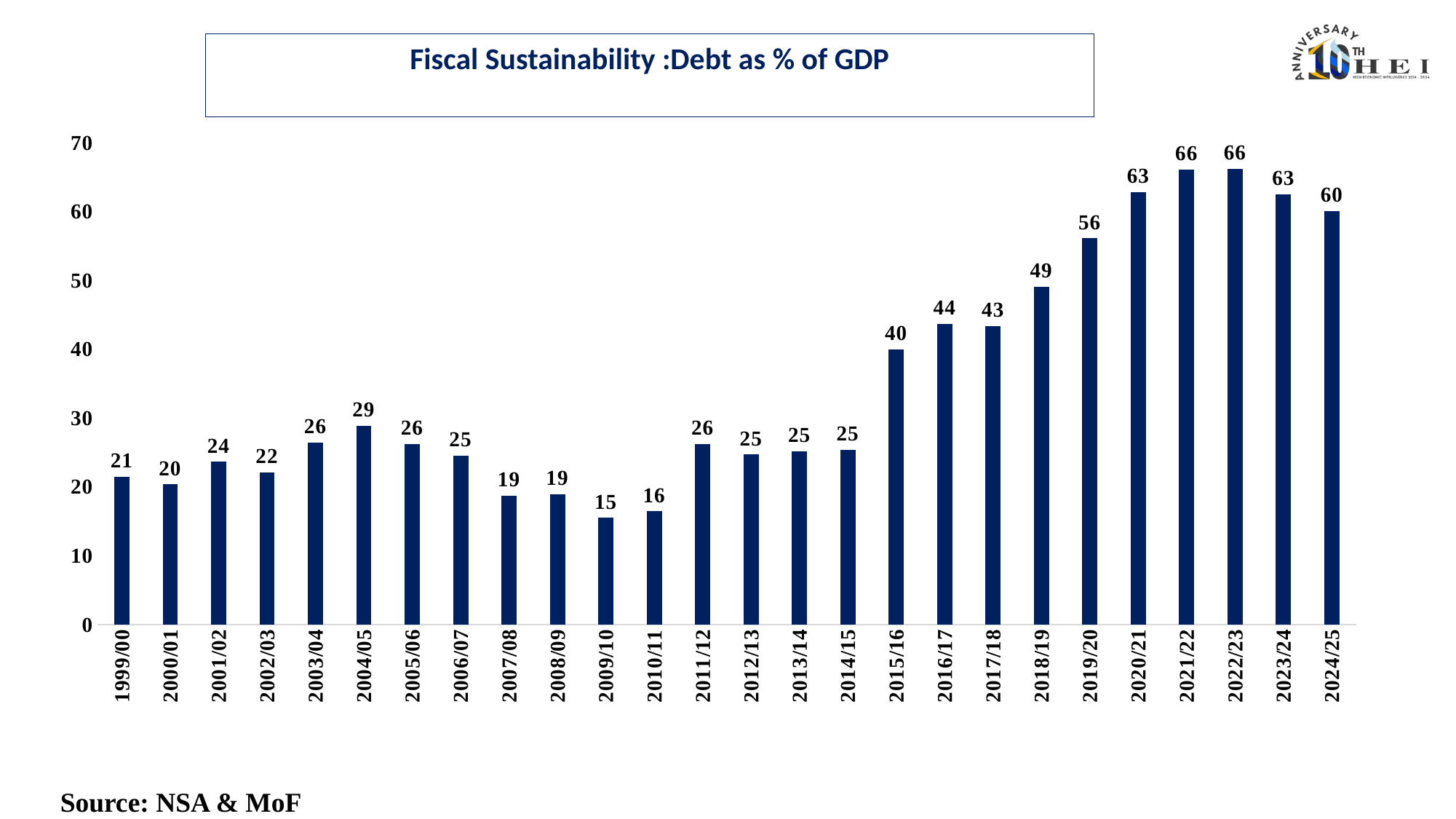
What kind of chart is this? Bar chart What is the value for 2024/25? 60 What is the title of the chart? Fiscal Sustainability :Debt as % of GDP How many years are shown on the x axis? 26 What is the difference between the values for 2018/19 and 2015/16? 9 What value is shown for 2009/10? 15 Is the value for 2020/21 greater or less than 60? greater What is the highest value shown on the chart? 66 Which year has the lowest debt as % of GDP? 2009/10 What is the debt as % of GDP for 2019/20? 56 Which is larger, the value for 2004/05 or the value for 2011/12? 2004/05 Do the values rise or fall from 2014/15 to 2021/22? Rise